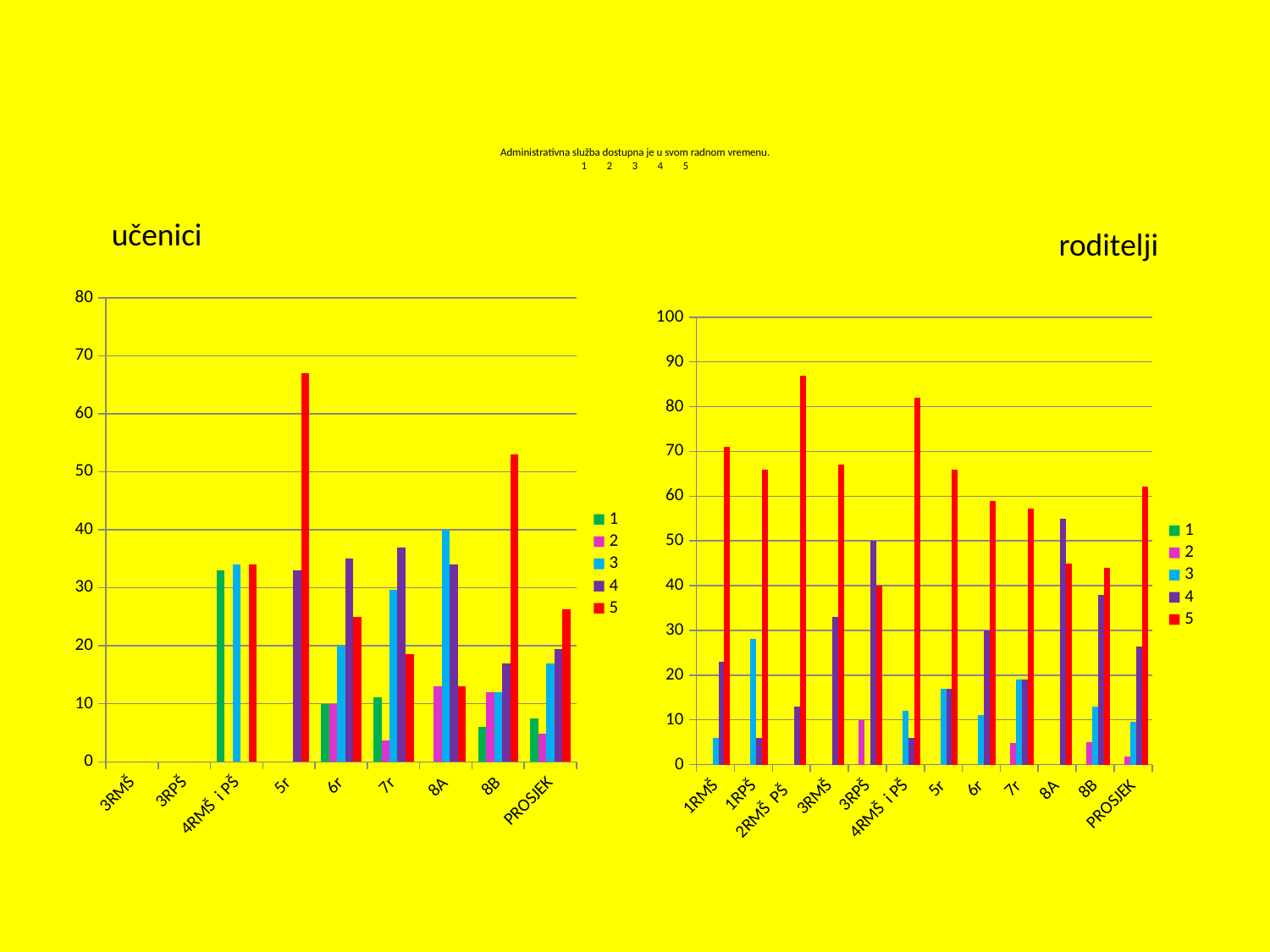
How many categories are shown on the x axis of the 'učenici' chart? 9 In the 'učenici' chart, which category has the highest value for series 5? 5r How many categories are shown on the x axis of the 'roditelji' chart? 12 In the 'učenici' chart, is the value of series 5 for 5r greater or less than 60? greater In the 'učenici' chart, for 8A, which is larger: series 3 or series 5? series 3 In the 'roditelji' chart, is the value of series 5 for 2RMŠ PŠ greater or less than 80? greater How many series does the legend of the 'roditelji' chart list? 5 In the 'roditelji' chart, which category has the highest value for series 5? 2RMŠ PŠ What colour represents series 5 in the legend of the 'roditelji' chart? red In the 'roditelji' chart, for 8A, which is larger: series 4 or series 5? series 4 What kind of chart is the 'učenici' chart on the left? bar chart In the 'učenici' chart, is the value of series 5 for 8B greater or less than 50? greater